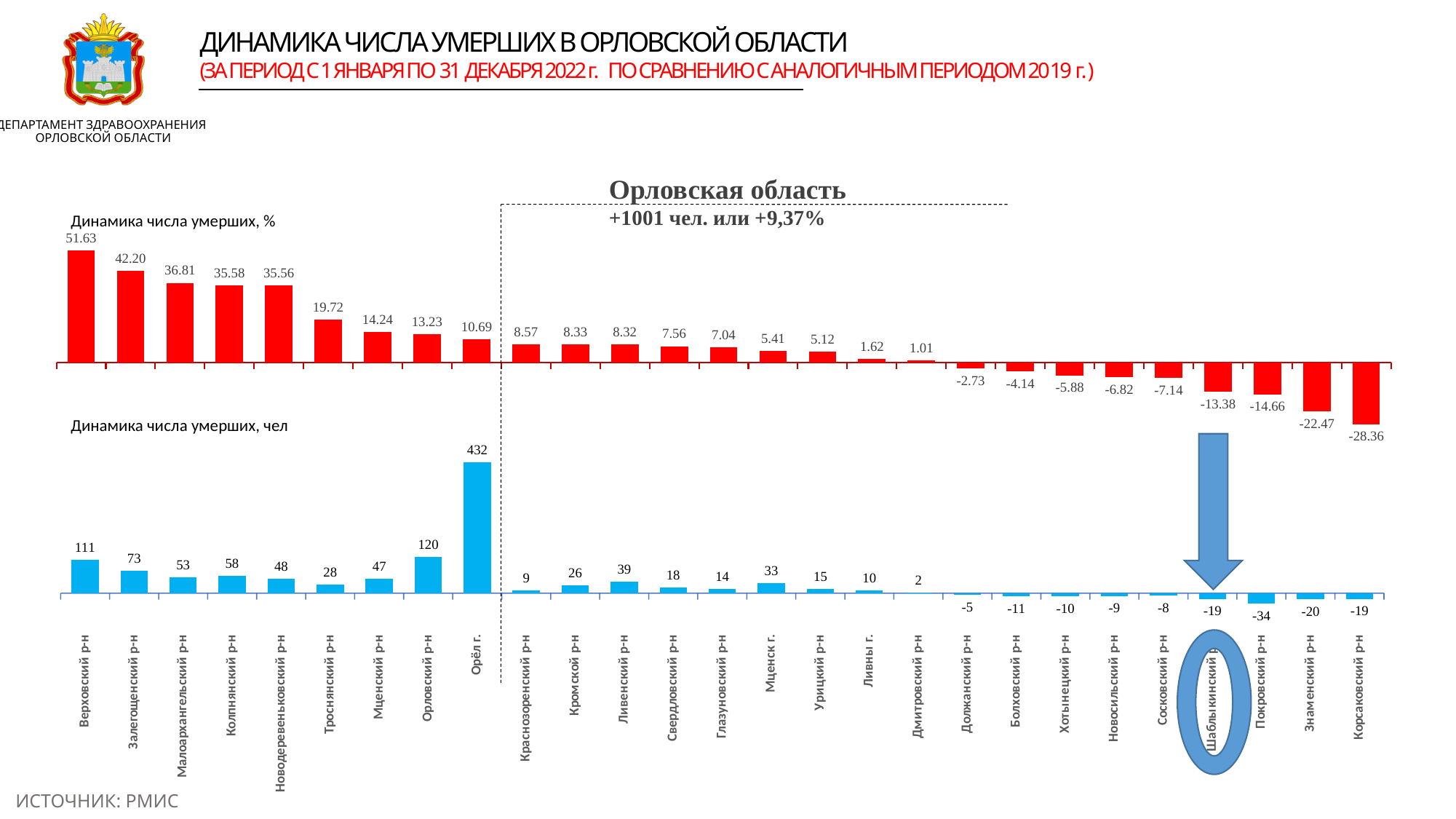
In the bottom chart 'Динамика числа умерших, чел', what is the value for Орёл г.? 432 In the bottom chart 'Динамика числа умерших, чел', which category has the highest value? Орёл г. In the bottom chart 'Динамика числа умерших, чел', what is the value for Покровский р-н? -34 How many categories are shown in the bottom chart 'Динамика числа умерших, чел'? 27 In the top chart 'Динамика числа умерших, %', which is larger: the value for Залегощенский р-н or the value for Малоархангельский р-н? Залегощенский р-н What total change for Орловская область is stated on the slide above the charts? +1001 чел. или +9,37% In the top chart 'Динамика числа умерших, %', what is the value for Верховский р-н? 51.63 In the bottom chart 'Динамика числа умерших, чел', what is the difference between the values for Орёл г. and Орловский р-н? 312 What kind of chart is the top chart 'Динамика числа умерших, %'? bar chart In the top chart 'Динамика числа умерших, %', do the values rise or fall from left to right along the x axis? fall In the top chart 'Динамика числа умерших, %', what is the value for Шаблыкинский р-н? -13.38 In the top chart 'Динамика числа умерших, %', which category has the lowest value? Корсаковский р-н